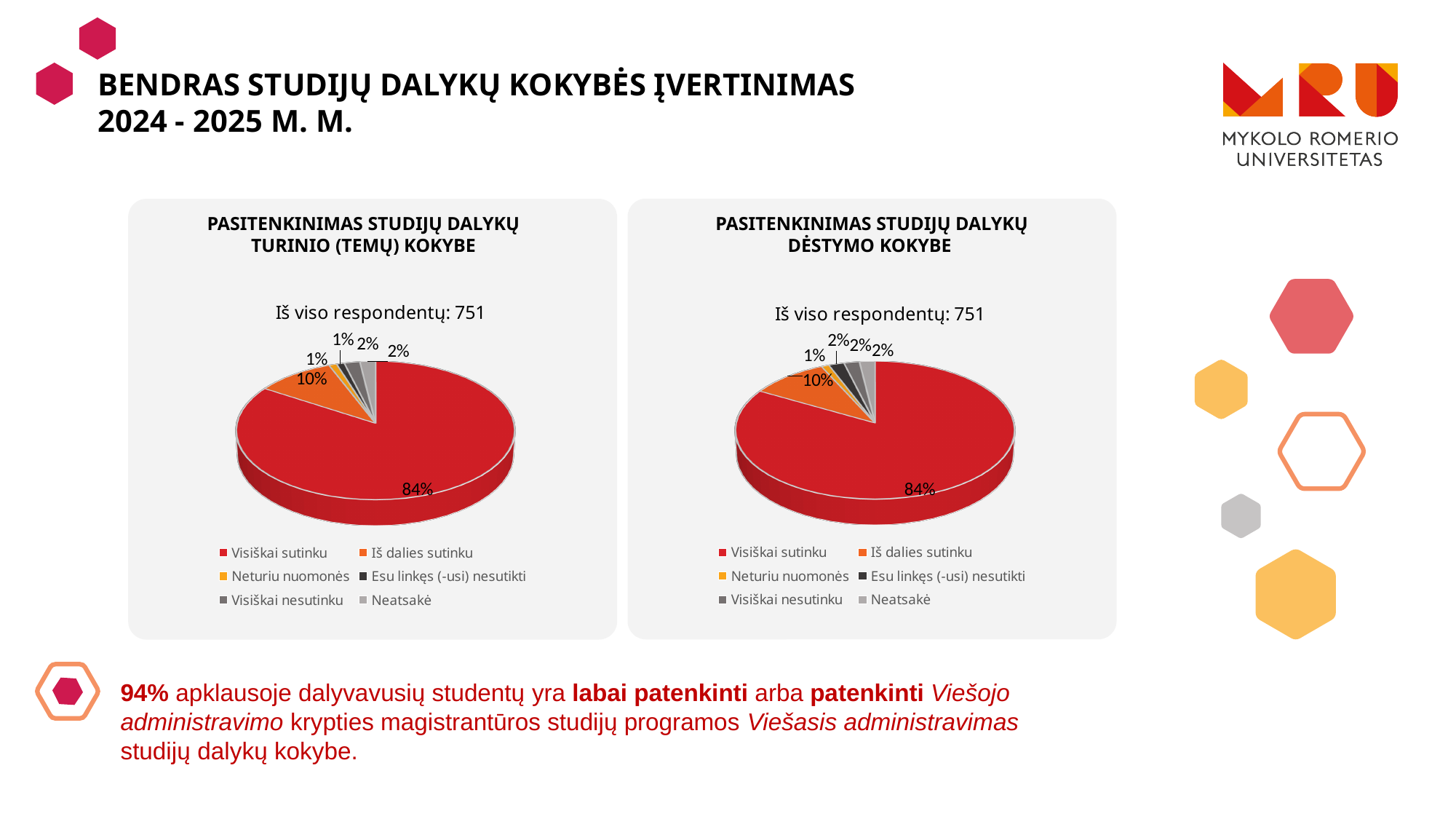
In the left chart (TURINIO (TEMŲ) KOKYBE), what share of respondents answered 'Iš dalies sutinku'? 10% How many respondents in total are reported for the right chart (DĖSTYMO KOKYBE)? 751 In the left chart (TURINIO (TEMŲ) KOKYBE), what colour is the slice for 'Visiškai sutinku'? Red In the left chart (TURINIO (TEMŲ) KOKYBE), which category has the largest slice? Visiškai sutinku In the chart titled 'PASITENKINIMAS STUDIJŲ DALYKŲ TURINIO (TEMŲ) KOKYBE', what share of respondents answered 'Visiškai sutinku'? 84% What type of chart is used in the 'PASITENKINIMAS STUDIJŲ DALYKŲ DĖSTYMO KOKYBE' panel? Pie chart In the left chart (TURINIO (TEMŲ) KOKYBE), what is the difference in percentage points between 'Visiškai sutinku' and 'Iš dalies sutinku'? 74 percentage points In the right chart (DĖSTYMO KOKYBE), which category has the largest slice? Visiškai sutinku In the right chart (DĖSTYMO KOKYBE), which is larger: the share for 'Visiškai sutinku' or the share for 'Iš dalies sutinku'? Visiškai sutinku In the chart titled 'PASITENKINIMAS STUDIJŲ DALYKŲ DĖSTYMO KOKYBE', what share of respondents answered 'Visiškai sutinku'? 84% How many categories does the legend of the left chart (TURINIO (TEMŲ) KOKYBE) list? 6 In the right chart (DĖSTYMO KOKYBE), what share of respondents answered 'Iš dalies sutinku'? 10%